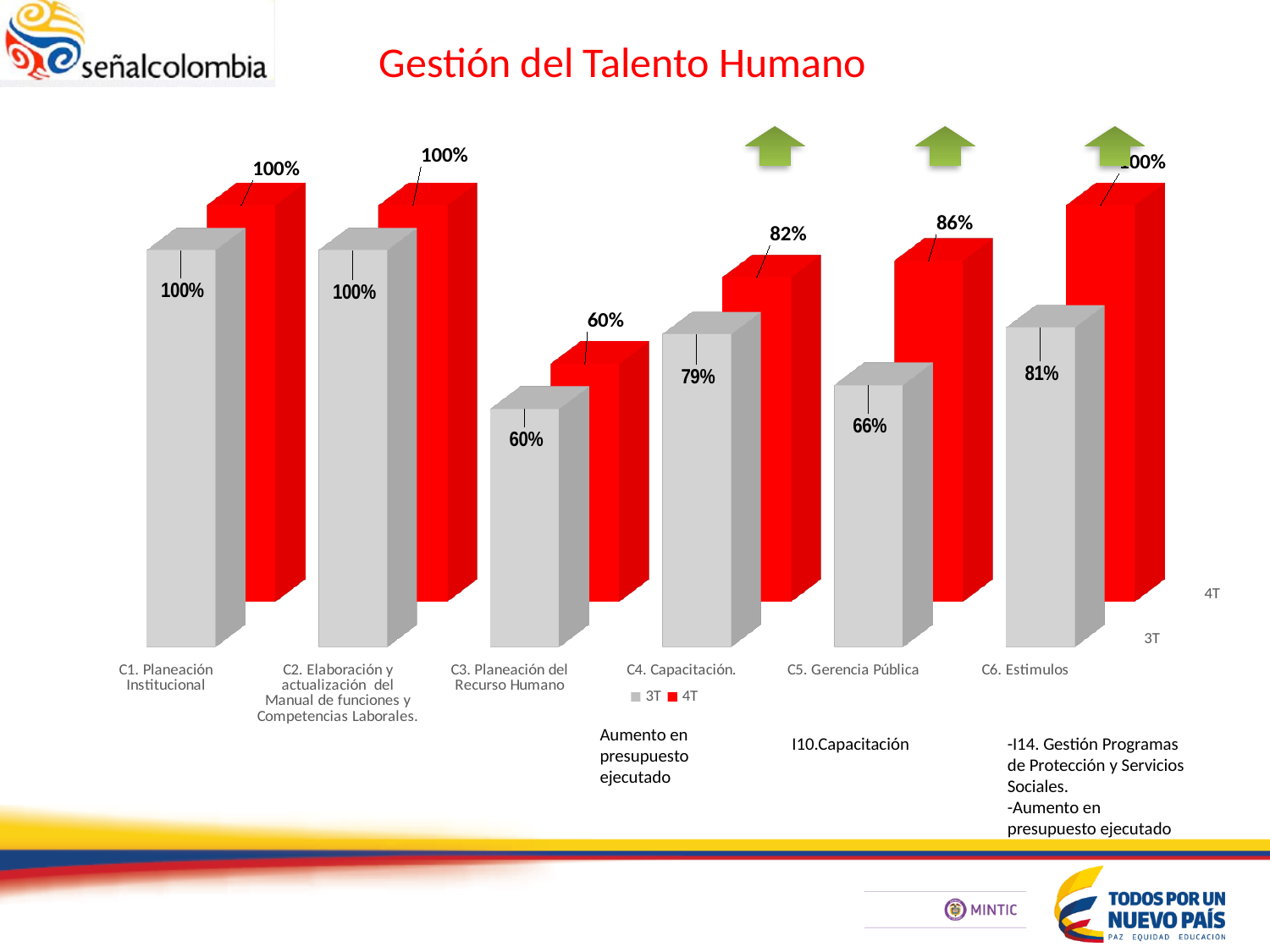
What is the 4T value for C3. Planeación del Recurso Humano? 60% What is the 4T value for C5. Gerencia Pública? 86% Which category has the lowest 3T value? C3. Planeación del Recurso Humano What is the 3T value for C6. Estimulos? 81% What is the 3T value for C5. Gerencia Pública? 66% What kind of chart is shown on the slide? Bar chart What is the difference between the 4T and 3T values for C5. Gerencia Pública? 20% How many series does the legend list? 2 What is the 4T value for C4. Capacitación? 82% What is the 3T value for C4. Capacitación? 79% Which has a higher 3T value, C4. Capacitación or C6. Estimulos? C6. Estimulos How many categories are shown on the x axis? 6